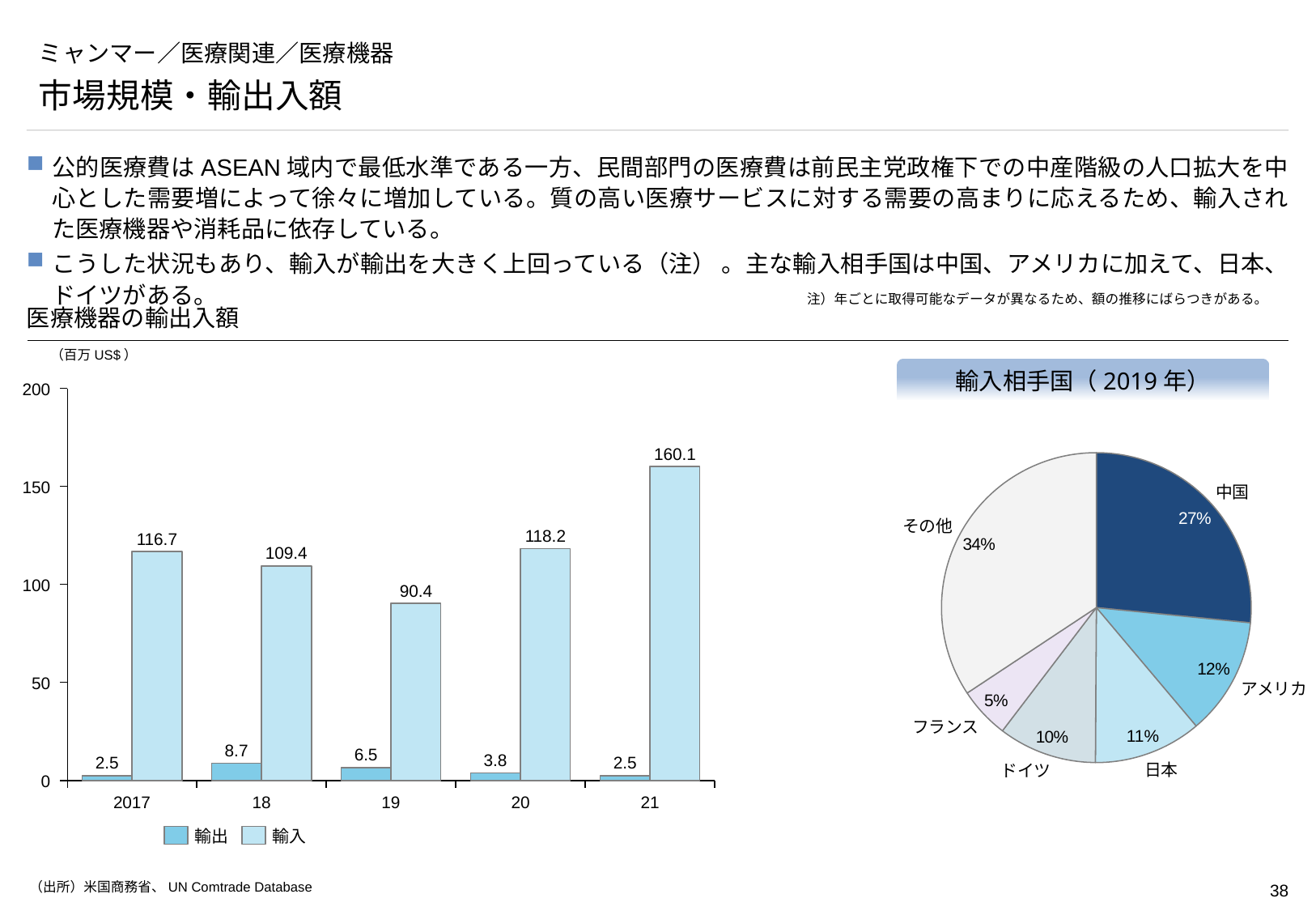
In the bar chart 医療機器の輸出入額, what is the value of 輸出 for 2018? 8.7 In the bar chart 医療機器の輸出入額, which year has the lowest 輸入 value? 2019 In the pie chart 輸入相手国（2019年）, what is the difference between the shares of アメリカ and ドイツ? 2% In the bar chart 医療機器の輸出入額, which is larger, the 輸出 value for 2019 or for 2020? 2019 In the pie chart 輸入相手国（2019年）, what share does 中国 have? 27% In the bar chart 医療機器の輸出入額, what is the value of 輸入 for 2021? 160.1 In the pie chart 輸入相手国（2019年）, which named country has the smallest share? フランス In the bar chart 医療機器の輸出入額, how many series does the legend list? 2 What kind of chart is 輸入相手国（2019年）? pie chart In the bar chart 医療機器の輸出入額, what is the difference between the 輸入 values for 2021 and 2020? 41.9 In the bar chart 医療機器の輸出入額, which year has the highest 輸入 value? 2021 In the bar chart 医療機器の輸出入額, how many years are shown on the x axis? 5